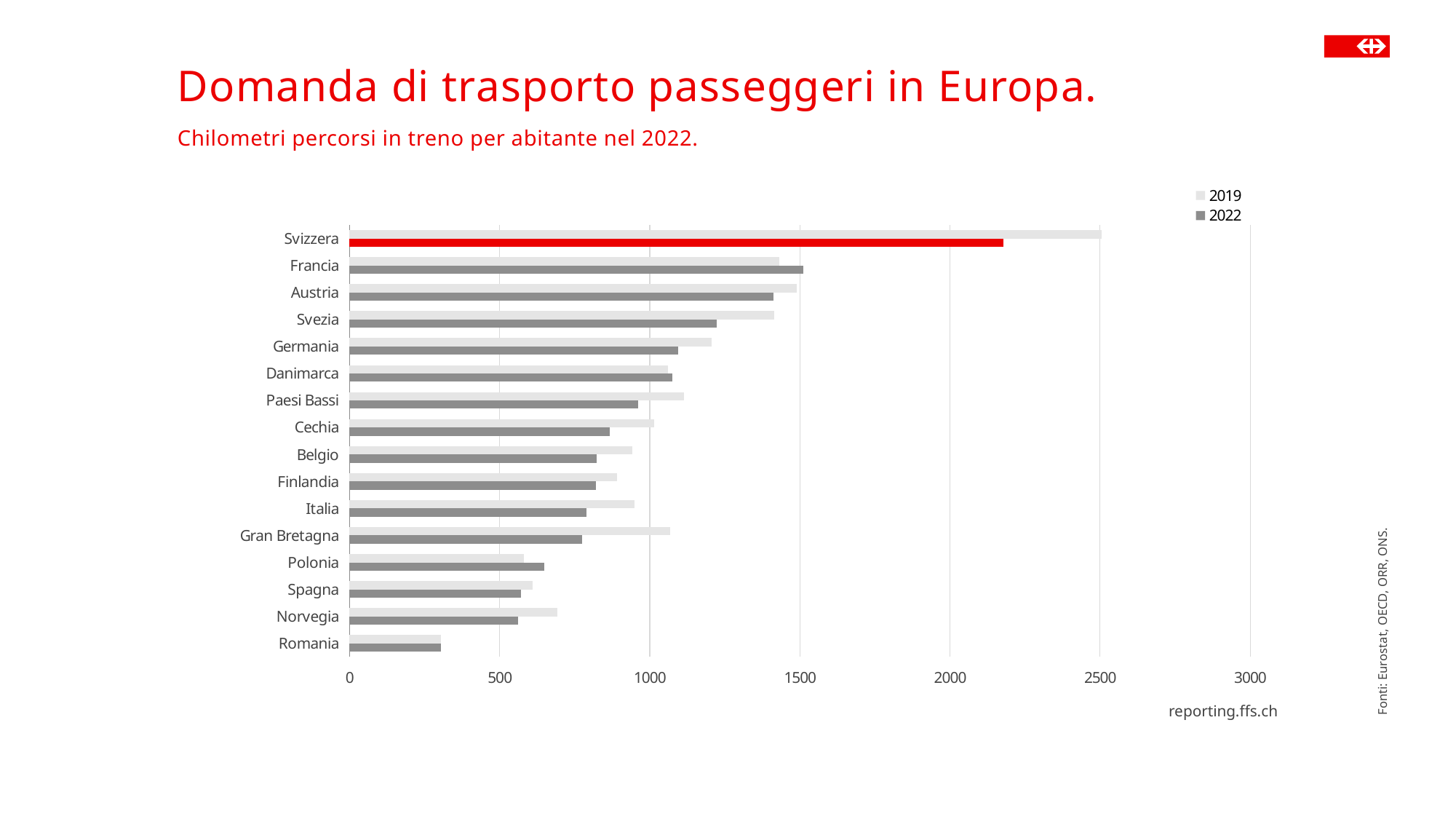
Is the 2022 value for Romania greater or less than 500? less How many countries are listed on the chart? 16 Which country has the lowest value for 2022? Romania Is the 2022 value for Svizzera greater or less than 2000? greater Is the 2022 value for Germania greater or less than 1000? greater What kind of chart is shown on the slide? bar chart Which country has the highest value for 2022? Svizzera How many series does the legend list? 2 Which is larger for Gran Bretagna, the 2019 value or the 2022 value? 2019 Which country's 2022 bar is highlighted in red? Svizzera Which is larger for Polonia, the 2019 value or the 2022 value? 2022